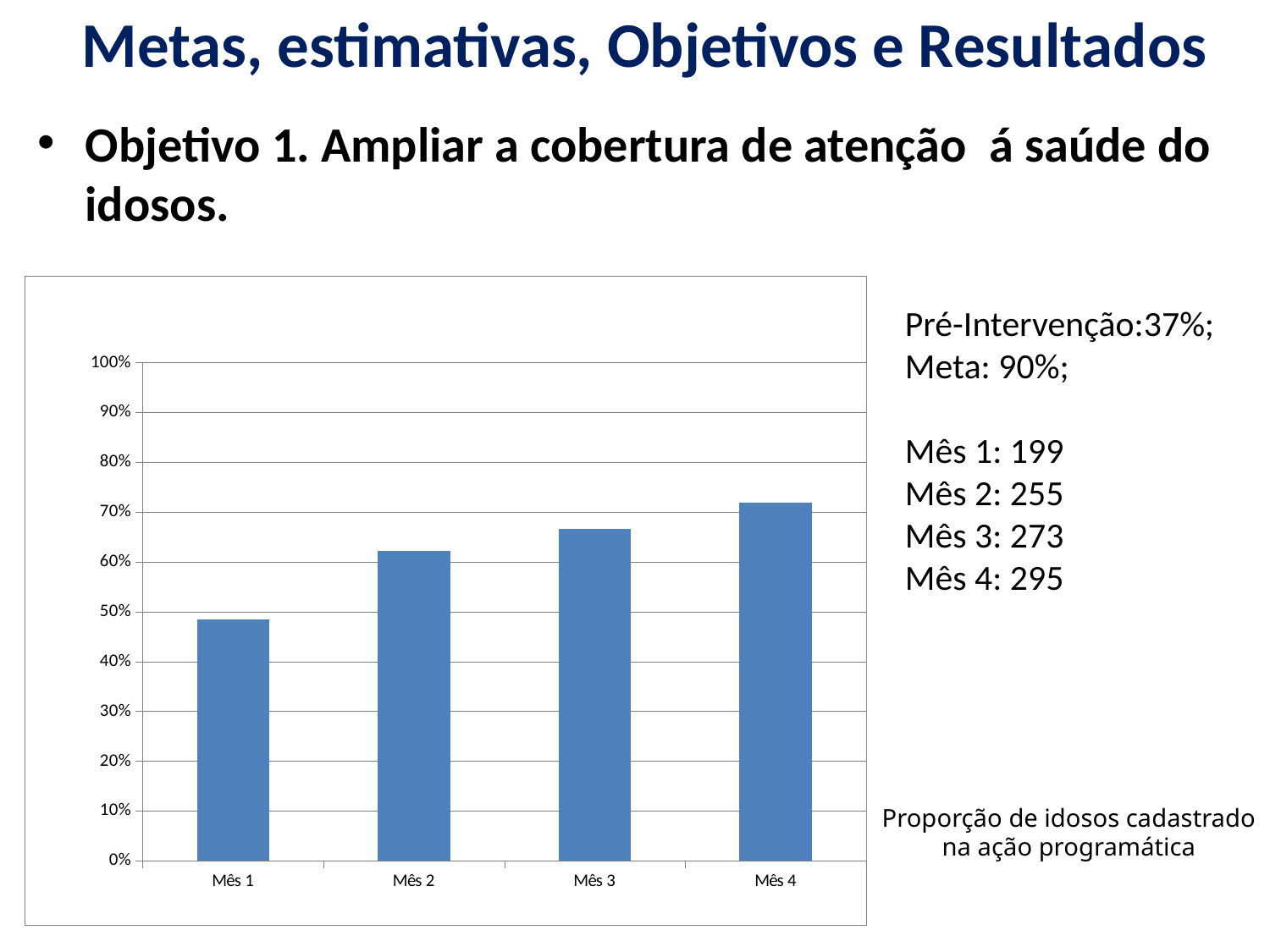
Which month has the lowest bar on the chart? Mês 1 Which month has the highest bar on the chart? Mês 4 Do the values rise or fall from Mês 1 to Mês 4? rise Is the value for Mês 1 greater or less than 50%? less What is the highest value shown on the vertical axis of the chart? 100% How many categories (months) are plotted on the chart? 4 Is the value for Mês 4 greater or less than 70%? greater What does the caption next to the chart say the chart shows? Proporção de idosos cadastrado na ação programática Is the value for Mês 3 greater or less than 70%? less Which is larger, the value for Mês 1 or the value for Mês 4? Mês 4 What kind of chart is shown on the slide? bar chart